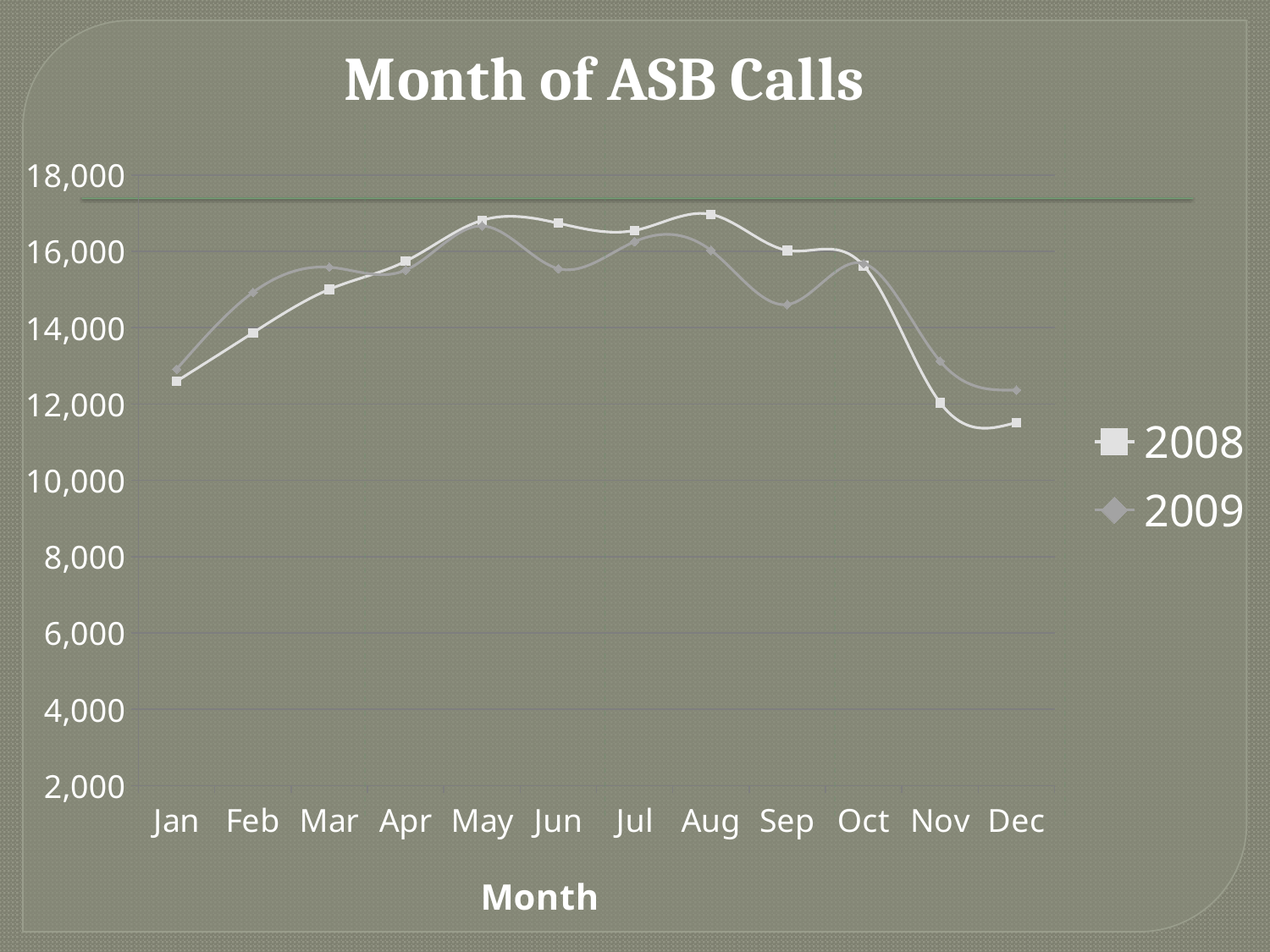
What is the title of the chart? Month of ASB Calls In Feb, which series has the larger value, 2008 or 2009? 2009 Is the value for 2008 in Dec greater or less than 12,000? less In Sep, which series has the larger value, 2008 or 2009? 2008 Which month has the highest value for the 2009 series? May Is the value for 2008 in Aug greater or less than 16,000? greater How many months are plotted along the x axis? 12 Is the value for 2009 in Jan greater or less than 14,000? less How many series does the legend list? 2 Which month has the lowest value for the 2008 series? Dec What kind of chart is shown on the slide? line chart